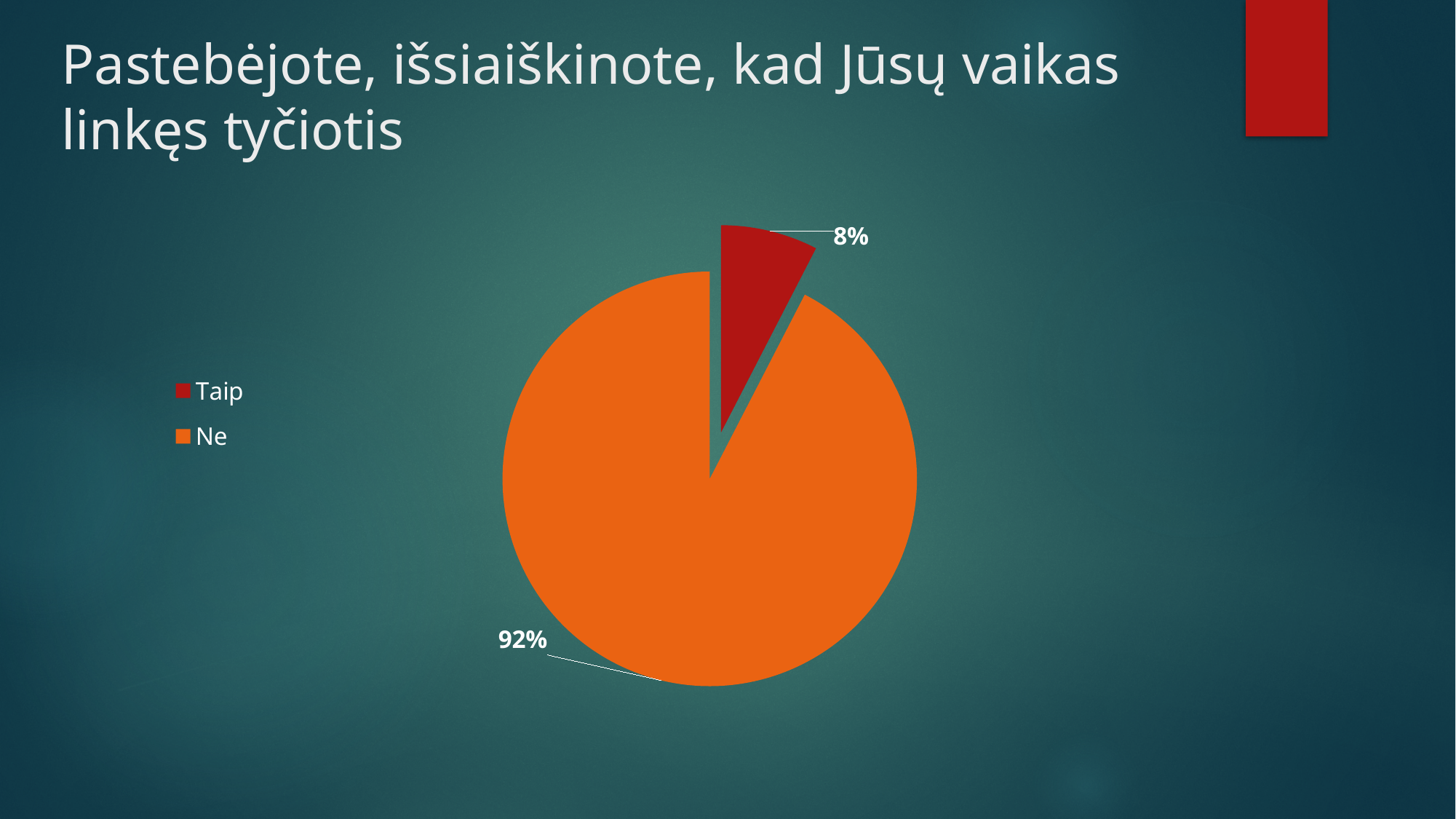
How many categories does the pie chart have? 2 Which category has the smallest share of the pie? Taip What percentage is shown for "Taip"? 8% Which is larger, the share for "Taip" or the share for "Ne"? Ne What share of the pie does the "Taip" slice represent? 8% Which category has the largest share of the pie? Ne What is the difference in percentage points between "Ne" and "Taip"? 84 What percentage is shown for "Ne"? 92% What colour is the "Taip" slice? dark red How many entries does the legend list? 2 What kind of chart is shown on the slide? pie chart What colour is the "Ne" slice? orange